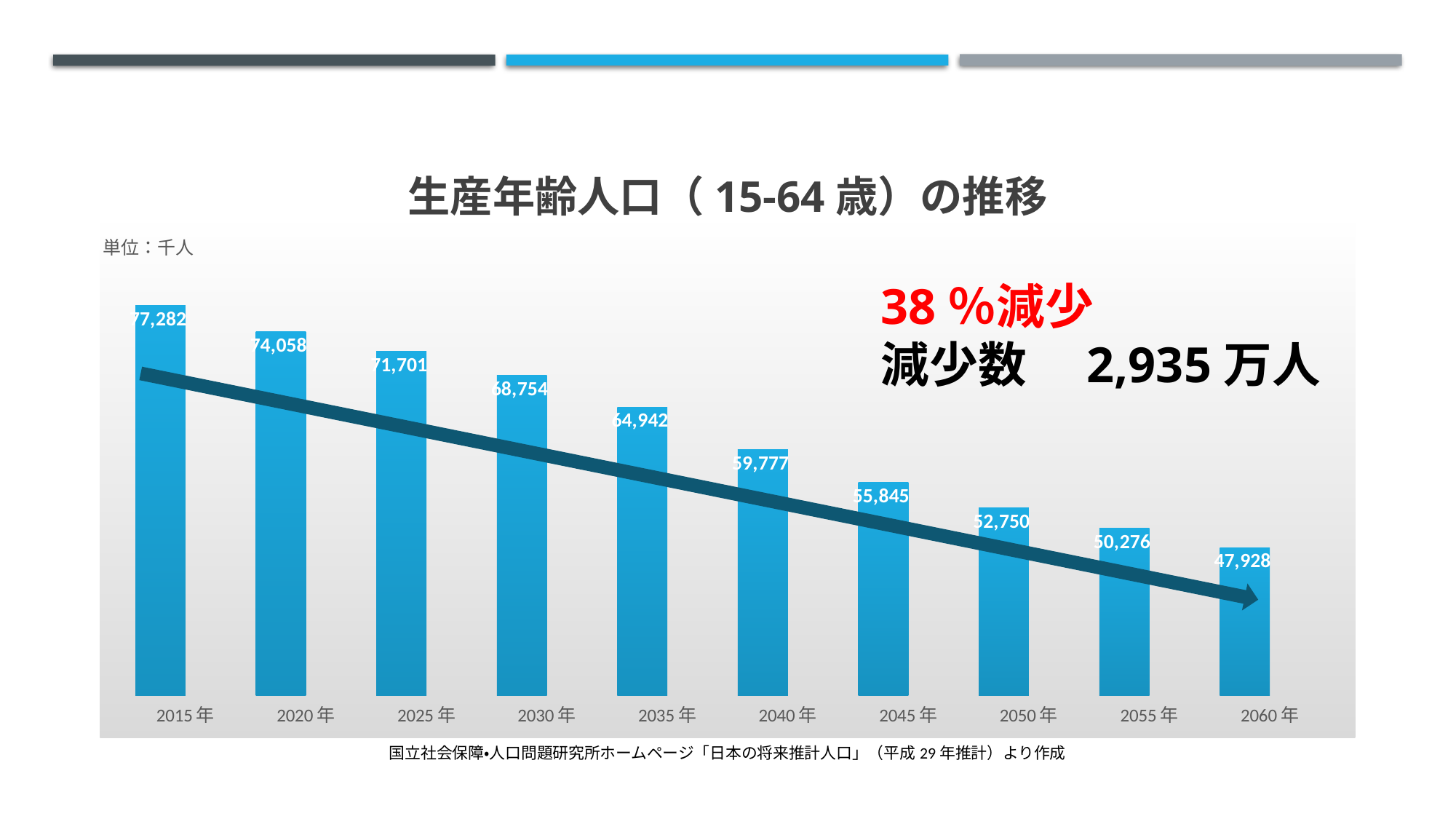
How many years are shown on the x axis? 10 What is the value for 2045年? 55,845 What is the value for 2020年? 74,058 What is the value for 2060年? 47,928 Which year has the lowest value? 2060年 Which year has the highest value? 2015年 Do the values rise or fall from 2015年 to 2060年? Fall What type of chart is shown on the slide? Bar chart What is the difference between the values for 2050年 and 2055年? 2,474 What is the value for 2025年? 71,701 Which is larger, the value for 2035年 or the value for 2050年? 2035年 What is the difference between the values for 2020年 and 2025年? 2,357